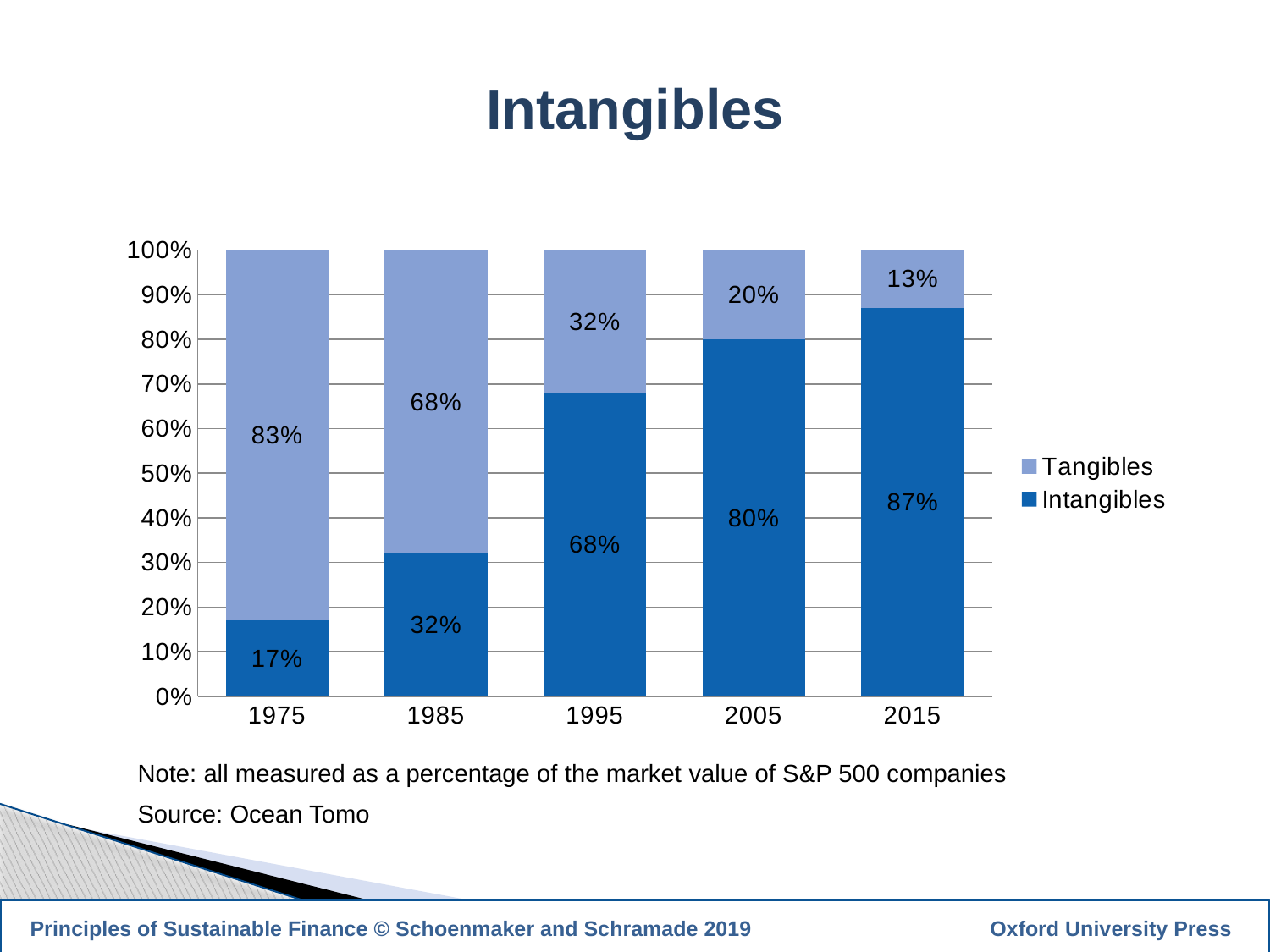
What is the value for Intangibles in 1975? 17% What is the difference between the Intangibles values for 2015 and 1975? 70% How many series does the legend list? 2 Which is larger in 1995, Tangibles or Intangibles? Intangibles What is the value for Intangibles in 2015? 87% What is the value for Tangibles in 2005? 20% In which year is the Tangibles value lowest? 2015 Do the Intangibles values rise or fall from 1975 to 2015? Rise What is the total of the stacked bar for 1985? 100% In which year is the Intangibles value highest? 2015 What kind of chart is shown on the slide? Stacked bar chart How many years are shown on the x axis? 5